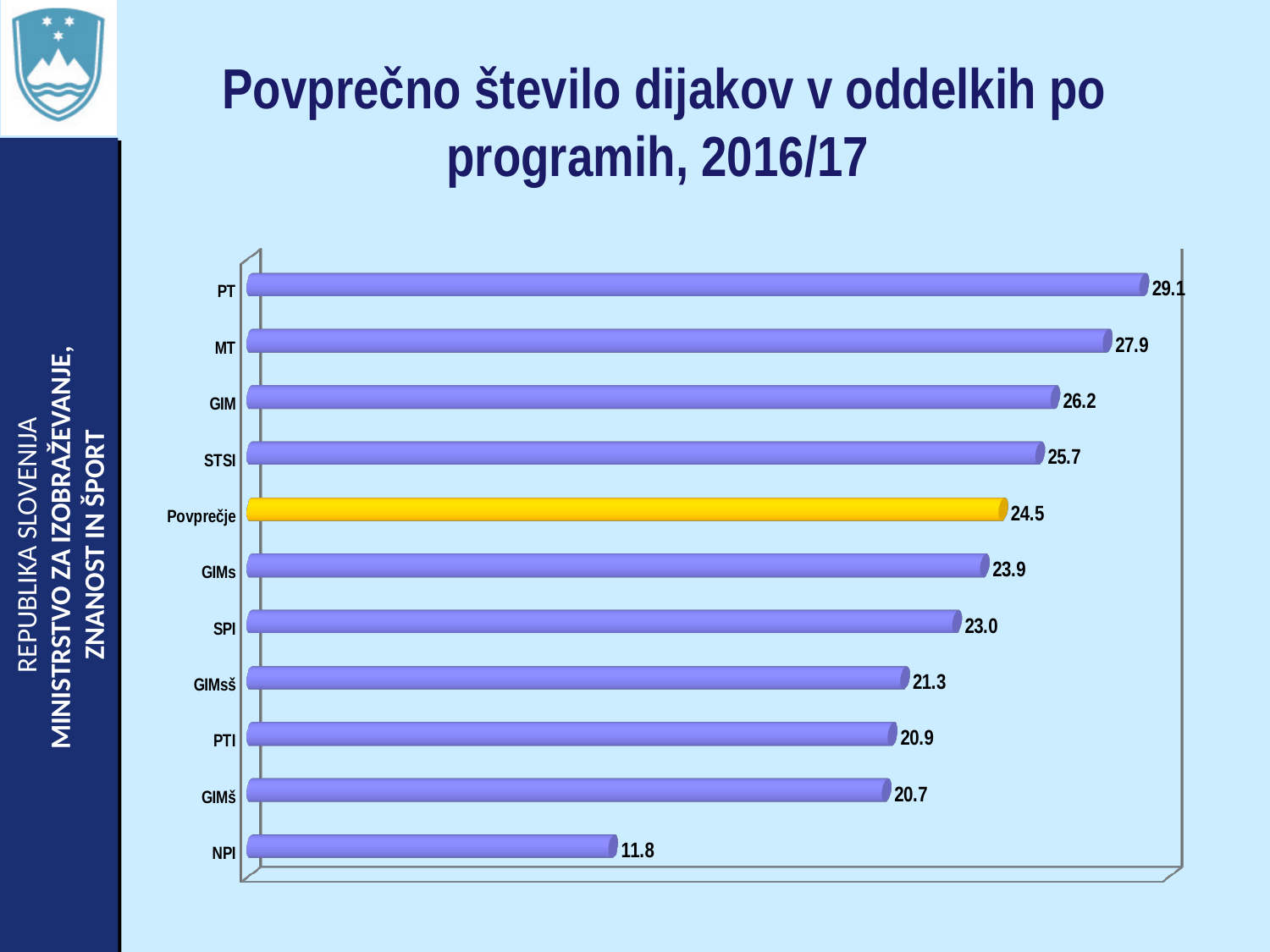
What is the value for Povprečje? 24.5 How many categories are shown in the chart? 11 Which is larger, the value for STSI or the value for SPI? STSI What is the value for NPI? 11.8 What is the value for GIMsš? 21.3 What is the difference between the values for PT and MT? 1.2 What is the value for PT? 29.1 What is the difference between the values for GIM and NPI? 14.4 Which category's bar is coloured yellow instead of blue? Povprečje Which category has the highest value? PT What kind of chart is shown on the slide? bar chart Which category has the lowest value? NPI